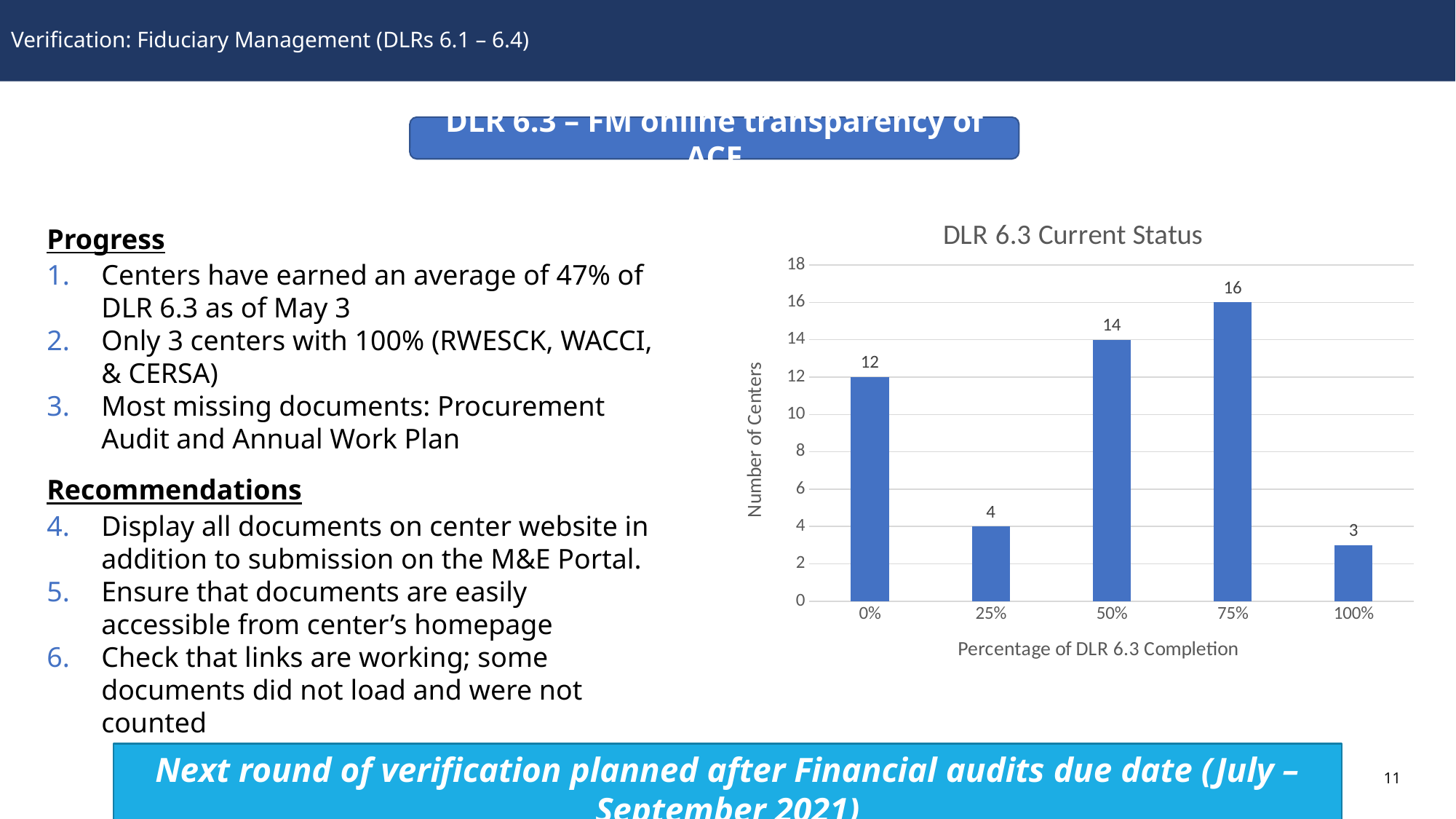
How many centers are at 25% completion? 4 How many completion categories are shown on the x axis? 5 How many centers are at 50% completion? 14 Which completion percentage has the lowest number of centers? 100% What is the title of the chart? DLR 6.3 Current Status Which has more centers: 0% completion or 50% completion? 50% Which completion percentage has the highest number of centers? 75% What kind of chart is DLR 6.3 Current Status? Bar chart How many centers are at 100% completion? 3 What is the number of centers at 0% completion in the DLR 6.3 Current Status chart? 12 What is the label of the y axis? Number of Centers What is the difference between the number of centers at 75% and at 100% completion? 13